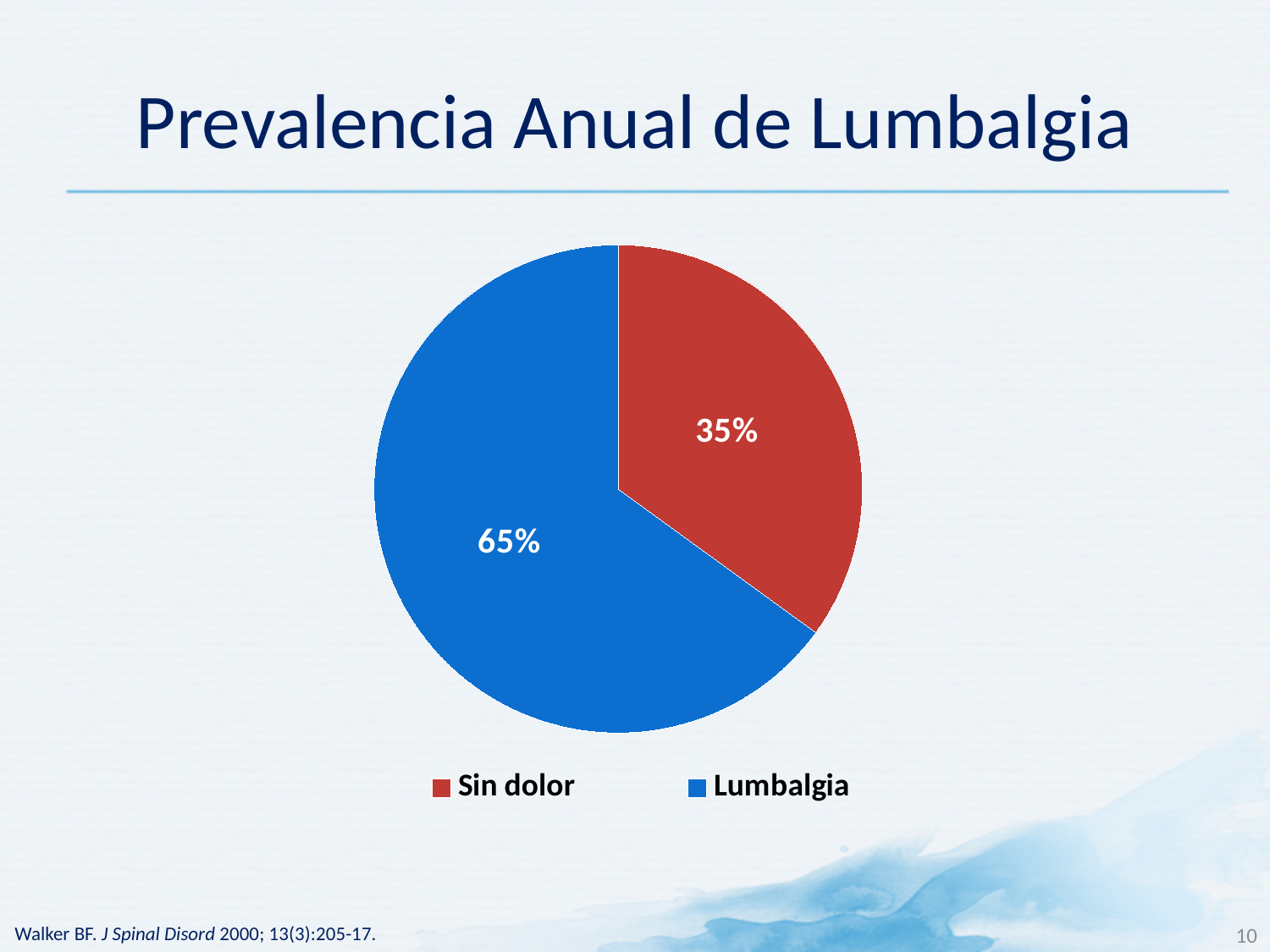
What percentage does the Lumbalgia slice show? 65% What colour is the Sin dolor slice? red What is the title of the slide containing the pie chart? Prevalencia Anual de Lumbalgia How many slices does the pie chart have? 2 Which is larger, the Sin dolor slice or the Lumbalgia slice? Lumbalgia What is the difference in percentage points between the Lumbalgia and Sin dolor slices? 30 What percentage does the Sin dolor slice show? 35% Which slice is the smallest? Sin dolor What type of chart is shown on the slide? pie chart Which slice is the largest? Lumbalgia How many entries does the legend list? 2 What share of the pie does the Lumbalgia slice represent? 65%